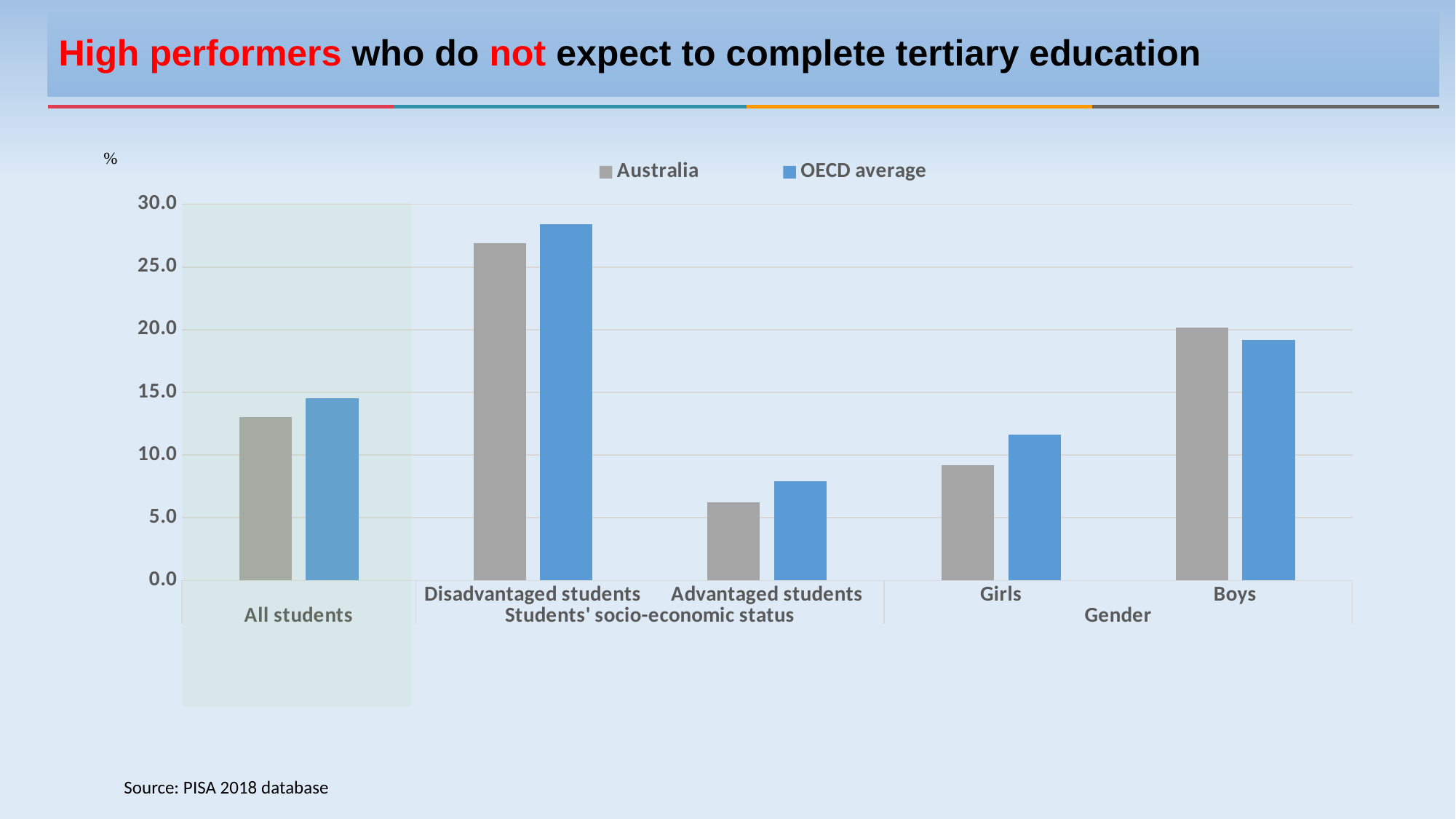
Is the OECD average value for Boys greater or less than 20.0? less Is the OECD average value for Disadvantaged students greater or less than 25.0? greater How many student categories are plotted along the x axis? 5 Is the Australia value for Girls greater or less than 10.0? less Which category has the lowest value for the OECD average? Advantaged students Which category has the highest value for Australia? Disadvantaged students For Girls, which is larger: the Australia value or the OECD average value? OECD average For Boys, which is larger: the Australia value or the OECD average value? Australia What colour are the bars for the OECD average series? blue How many series does the legend list? 2 What kind of chart is shown on the slide? bar chart